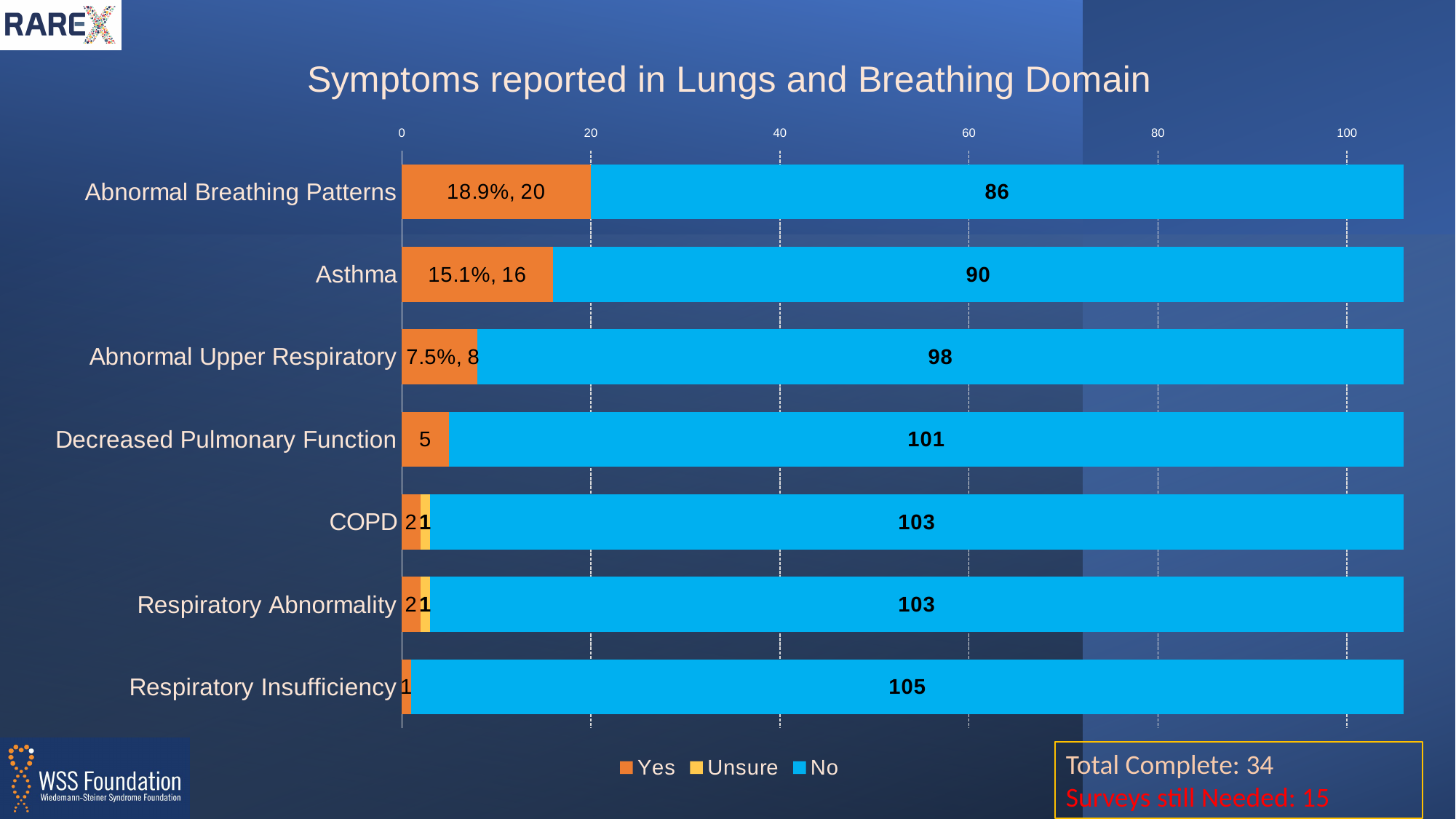
What is the difference between the 'No' values for Decreased Pulmonary Function and Abnormal Breathing Patterns? 15 How many series does the legend list? 3 What is the total of the stacked bar for COPD? 106 What is the 'Yes' value for Abnormal Breathing Patterns? 20 What percentage is shown for the 'Yes' segment of Abnormal Upper Respiratory? 7.5% What is the title of the chart? Symptoms reported in Lungs and Breathing Domain Which category has the lowest 'Yes' value? Respiratory Insufficiency Which is larger, the 'Yes' value for Asthma or the 'Yes' value for Decreased Pulmonary Function? Asthma How many symptom categories are plotted on the chart? 7 Which category has the highest 'No' value? Respiratory Insufficiency What is the 'No' value for Asthma? 90 What kind of chart is shown on the slide? Stacked bar chart